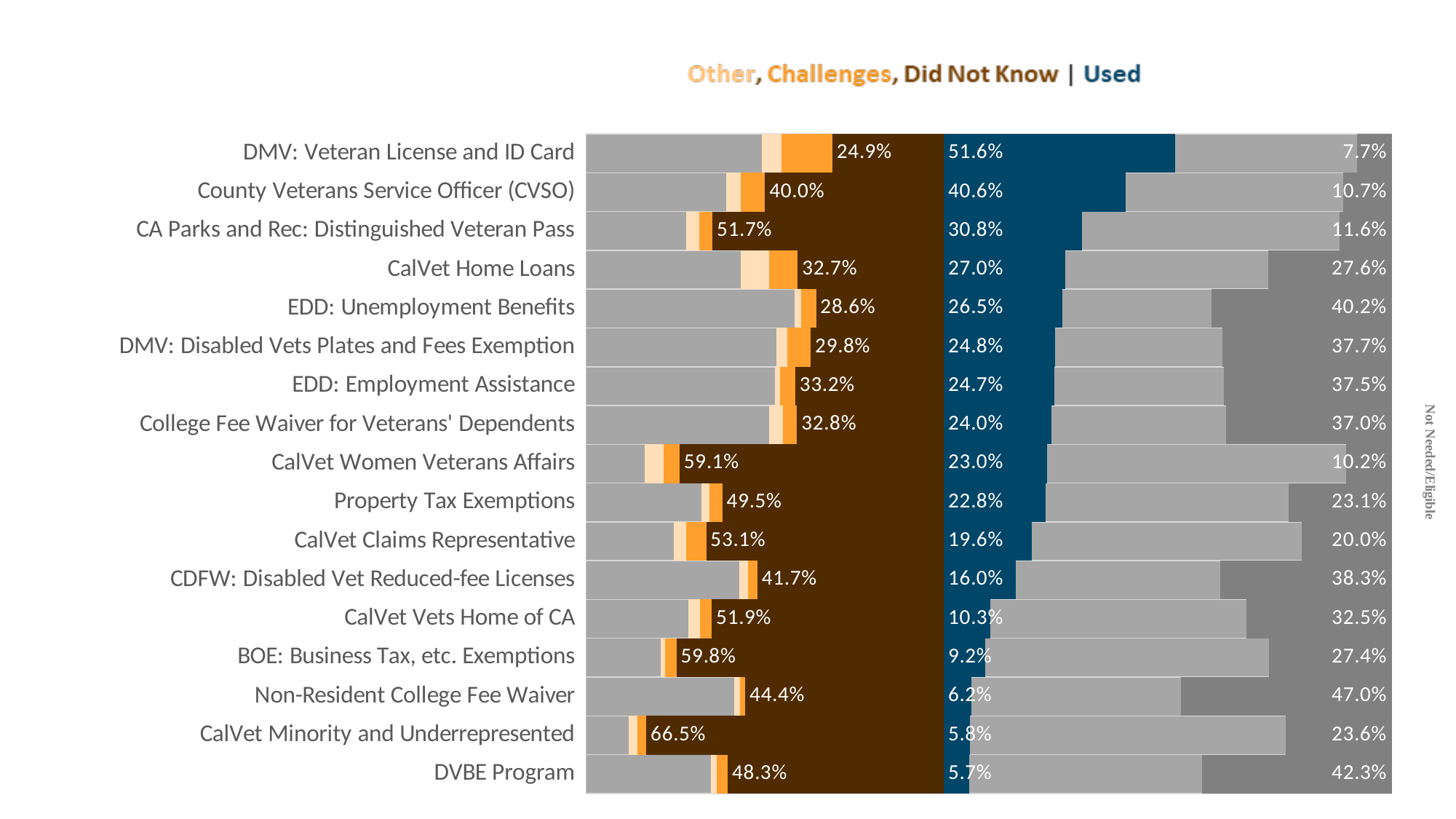
Which program has the lowest 'Used' value? DVBE Program Which program has the highest 'Not Needed/Eligible' value? Non-Resident College Fee Waiver What is the 'Not Needed/Eligible' value for EDD: Unemployment Benefits? 40.2% What is the difference between the 'Used' values for DMV: Veteran License and ID Card and County Veterans Service Officer (CVSO)? 11.0% How many programs (categories) are listed on the chart? 17 What kind of chart is shown on the slide? bar chart Which colour represents the 'Used' series in the chart? blue Which program has the highest 'Did Not Know' value? CalVet Minority and Underrepresented What is the 'Did Not Know' value for CalVet Women Veterans Affairs? 59.1% Which has a larger 'Did Not Know' value, CA Parks and Rec: Distinguished Veteran Pass or CalVet Home Loans? CA Parks and Rec: Distinguished Veteran Pass Which program has the highest 'Used' value? DMV: Veteran License and ID Card What is the 'Used' value for DMV: Veteran License and ID Card? 51.6%